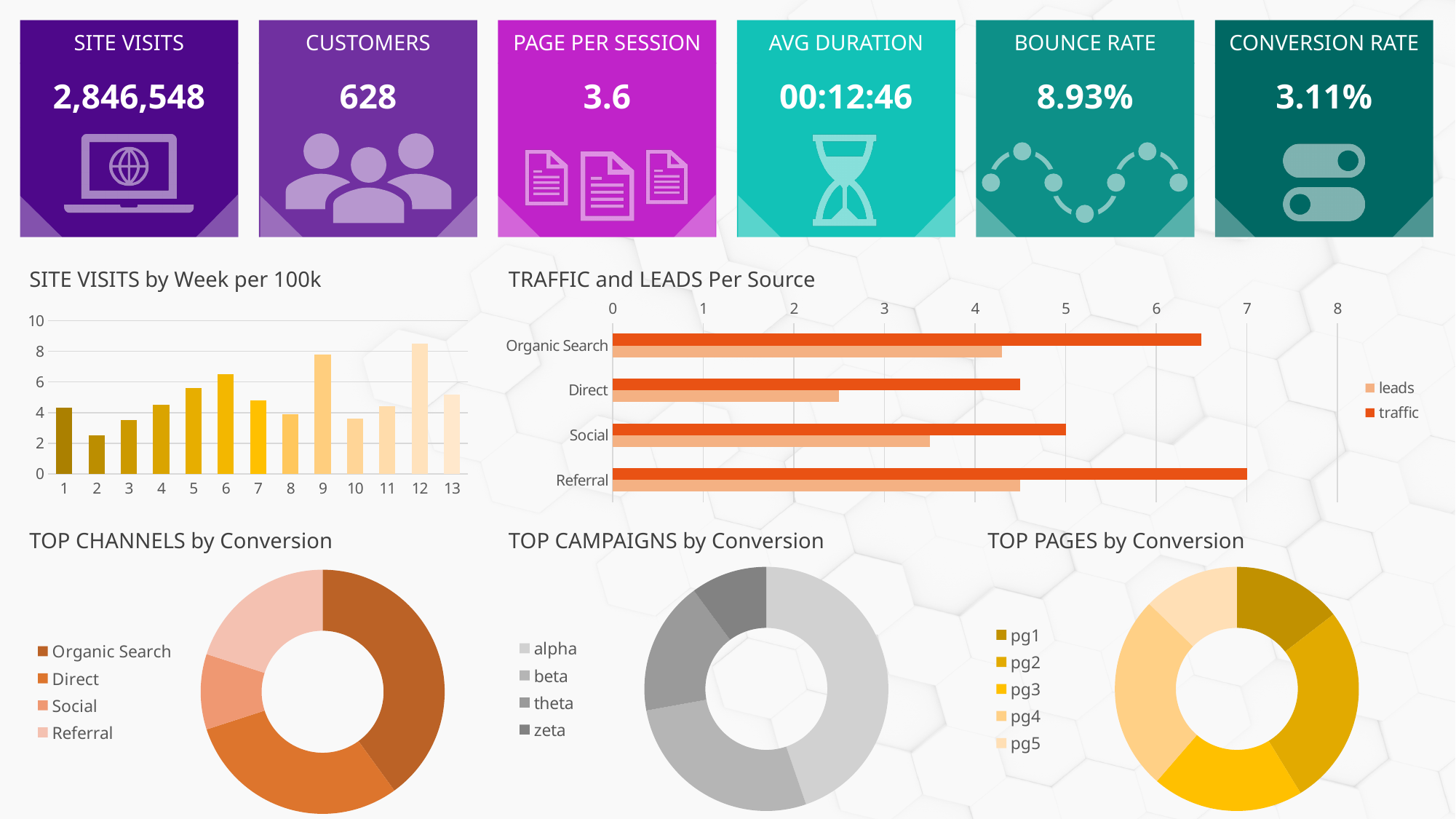
In the "TRAFFIC and LEADS Per Source" chart, which source has the lowest leads value? Direct In the "SITE VISITS by Week per 100k" chart, which week has the highest value? 12 In the "SITE VISITS by Week per 100k" chart, how many weeks are plotted? 13 In the "TRAFFIC and LEADS Per Source" chart, how many series does the legend list? 2 In the "TRAFFIC and LEADS Per Source" chart, which source has the highest traffic value? Referral In the "TRAFFIC and LEADS Per Source" chart, how many sources are plotted? 4 What kind of chart is the "SITE VISITS by Week per 100k" chart? bar chart In the "SITE VISITS by Week per 100k" chart, which week has the lowest value? 2 In the "TOP PAGES by Conversion" chart, how many pages does the legend list? 5 In the "TOP CAMPAIGNS by Conversion" chart, which campaign has the largest share? alpha In the "TRAFFIC and LEADS Per Source" chart, is the leads value for Direct greater or less than 3? less In the "SITE VISITS by Week per 100k" chart, is the value for week 9 greater or less than 6? greater